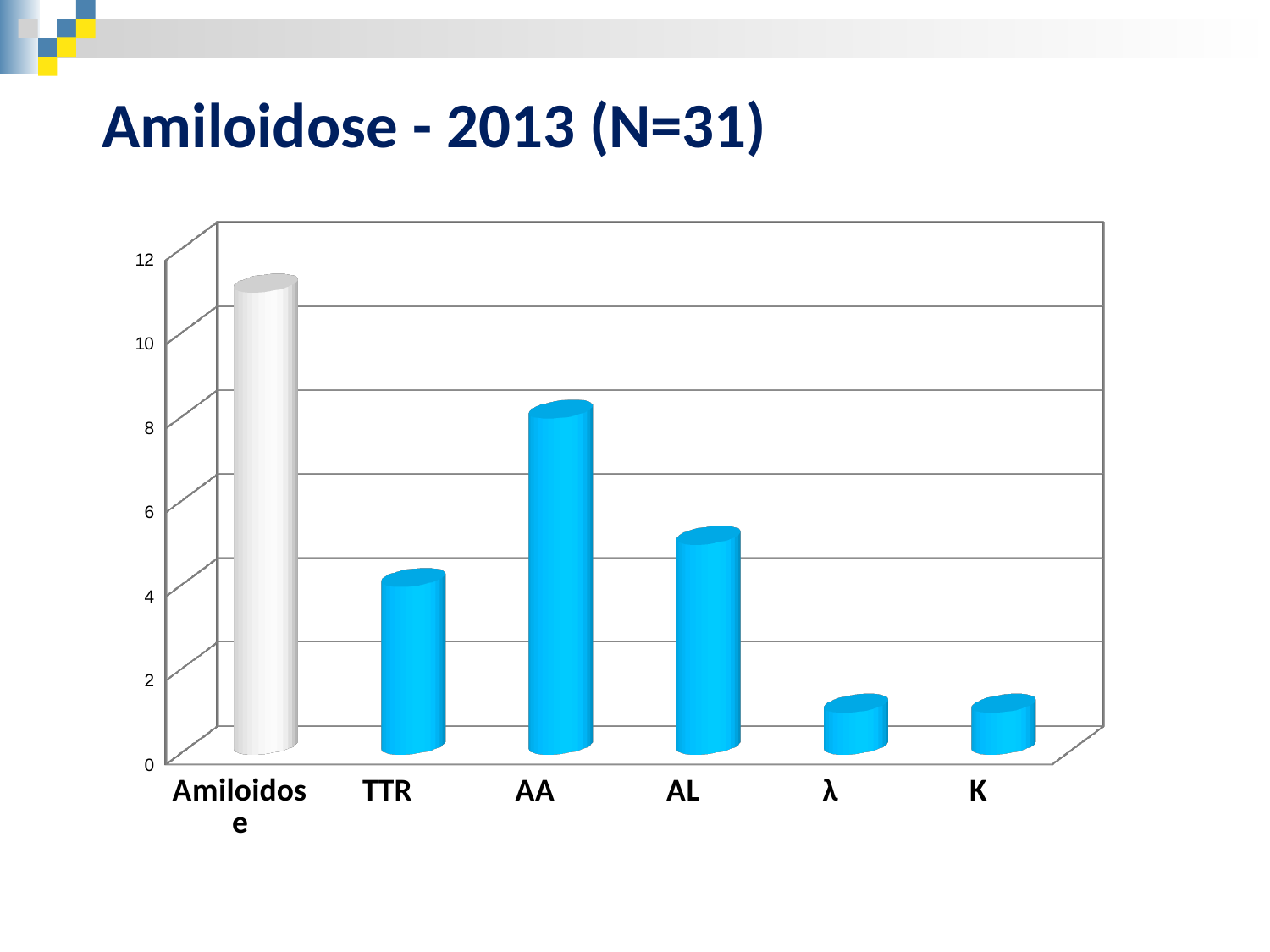
What kind of chart is shown on the slide? bar chart Is the value for λ greater or less than 2? less How many categories are shown on the x axis? 6 Which is larger, the value for AA or the value for AL? AA Is the value for K greater or less than 2? less Which category has the highest bar? Amiloidose Is the value for AA greater or less than 6? greater Which is larger, the value for TTR or the value for AL? AL What is the title of the chart? Amiloidose - 2013 (N=31) Which bar is shown in a different colour (white) from the others? Amiloidose